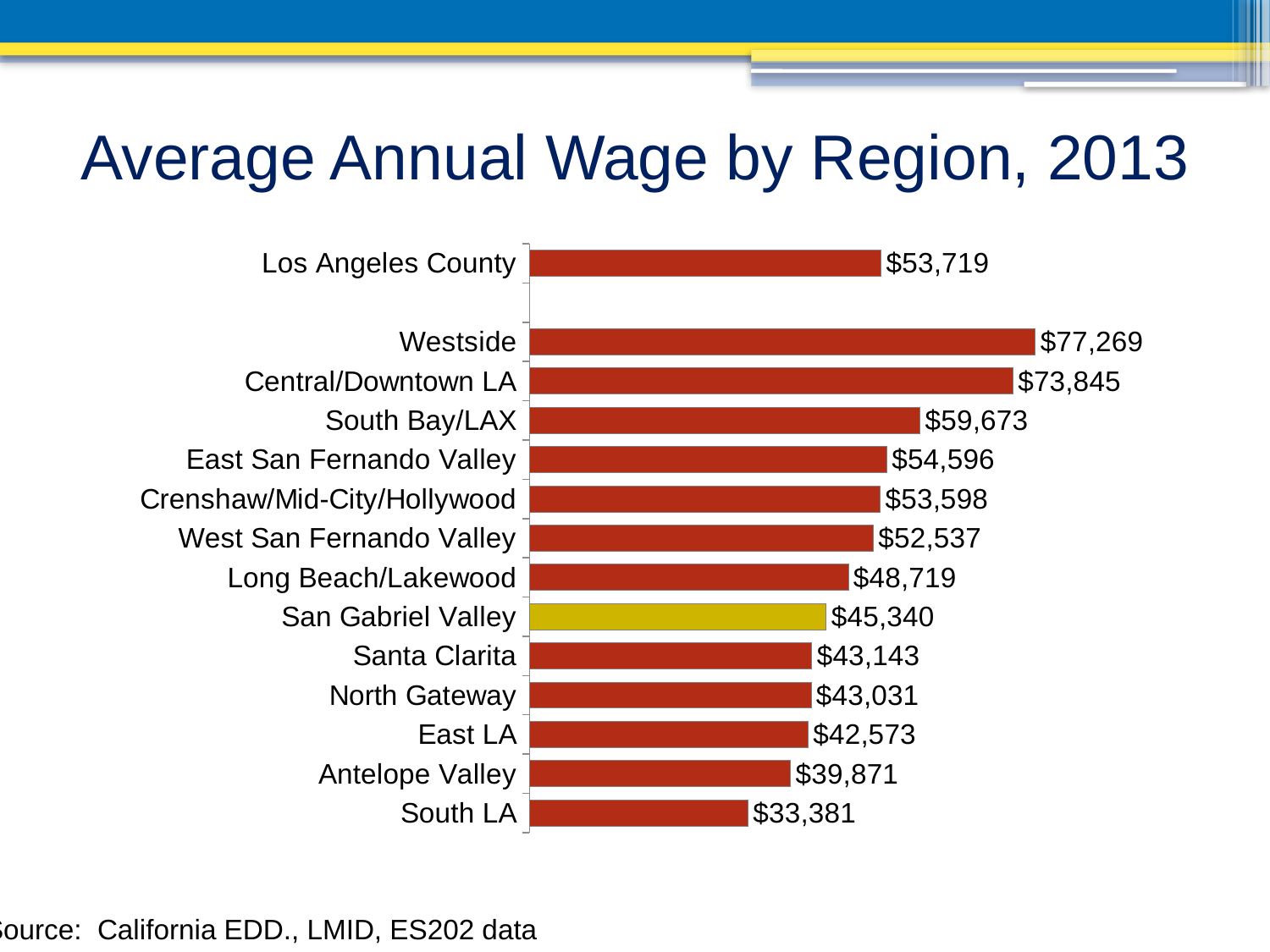
What is the average annual wage for San Gabriel Valley? $45,340 Which has a higher average annual wage, South Bay/LAX or Long Beach/Lakewood? South Bay/LAX Which region's bar is shown in a different colour (yellow) from the others? San Gabriel Valley How many regions are shown in the chart? 14 What is the average annual wage for Westside? $77,269 What is the difference between the average annual wage for Westside and Central/Downtown LA? $3,424 What is the average annual wage for Antelope Valley? $39,871 What type of chart is shown on the slide? Bar chart Which region has the highest average annual wage? Westside Which region has the lowest average annual wage? South LA How much lower is the average annual wage for San Gabriel Valley than for Los Angeles County? $8,379 What is the average annual wage for Los Angeles County? $53,719